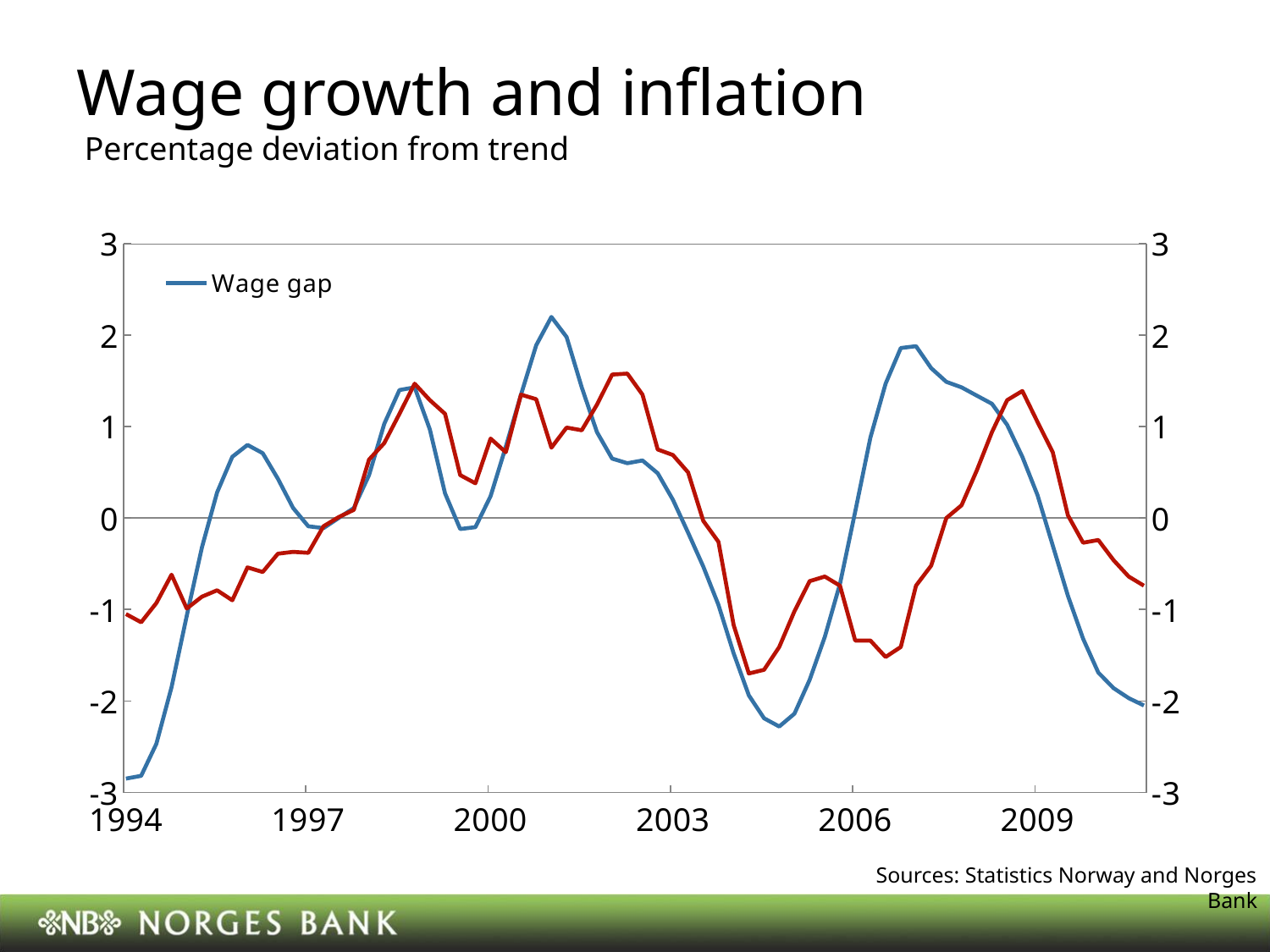
How many series does the chart's legend list? 1 What colour is the Wage gap line? blue Does the Wage gap line rise or fall between 2007 and 2010? falls Is the Wage gap value in 1996 greater or less than 0? greater Is the Wage gap value at the start of 1994 greater or less than -2? less Is the Wage gap value at the right end of the chart (around 2010) greater or less than -1? less Does the Wage gap line rise or fall between 1994 and 1996? rises What is the title of the chart on the slide? Wage growth and inflation What kind of chart is shown on the slide? line chart